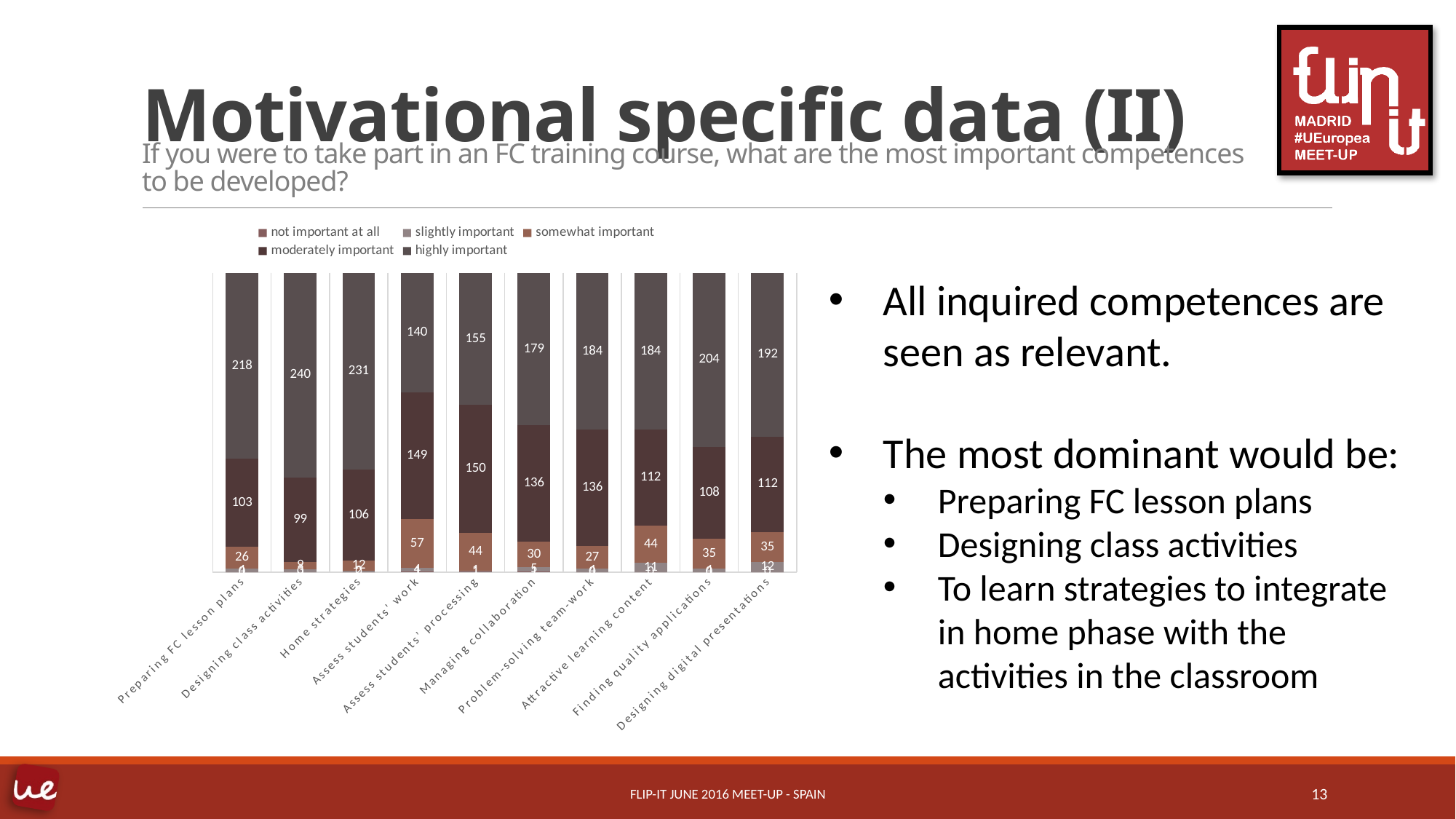
How many series does the legend list? 5 Which category has the highest 'somewhat important' value? Assess students' work What is the 'moderately important' value for Assess students' processing? 150 What is the 'somewhat important' value for Assess students' work? 57 What is the 'highly important' value for Designing class activities? 240 Which has the larger 'moderately important' value: Assess students' work or Managing collaboration? Assess students' work How many competence categories are plotted along the x axis? 10 Which category has the highest 'highly important' value? Designing class activities What kind of chart is shown on the slide? Stacked bar chart Which category has the lowest 'highly important' value? Assess students' work What is the difference between the 'highly important' values for Home strategies and Preparing FC lesson plans? 13 What is the first entry listed in the chart legend? not important at all